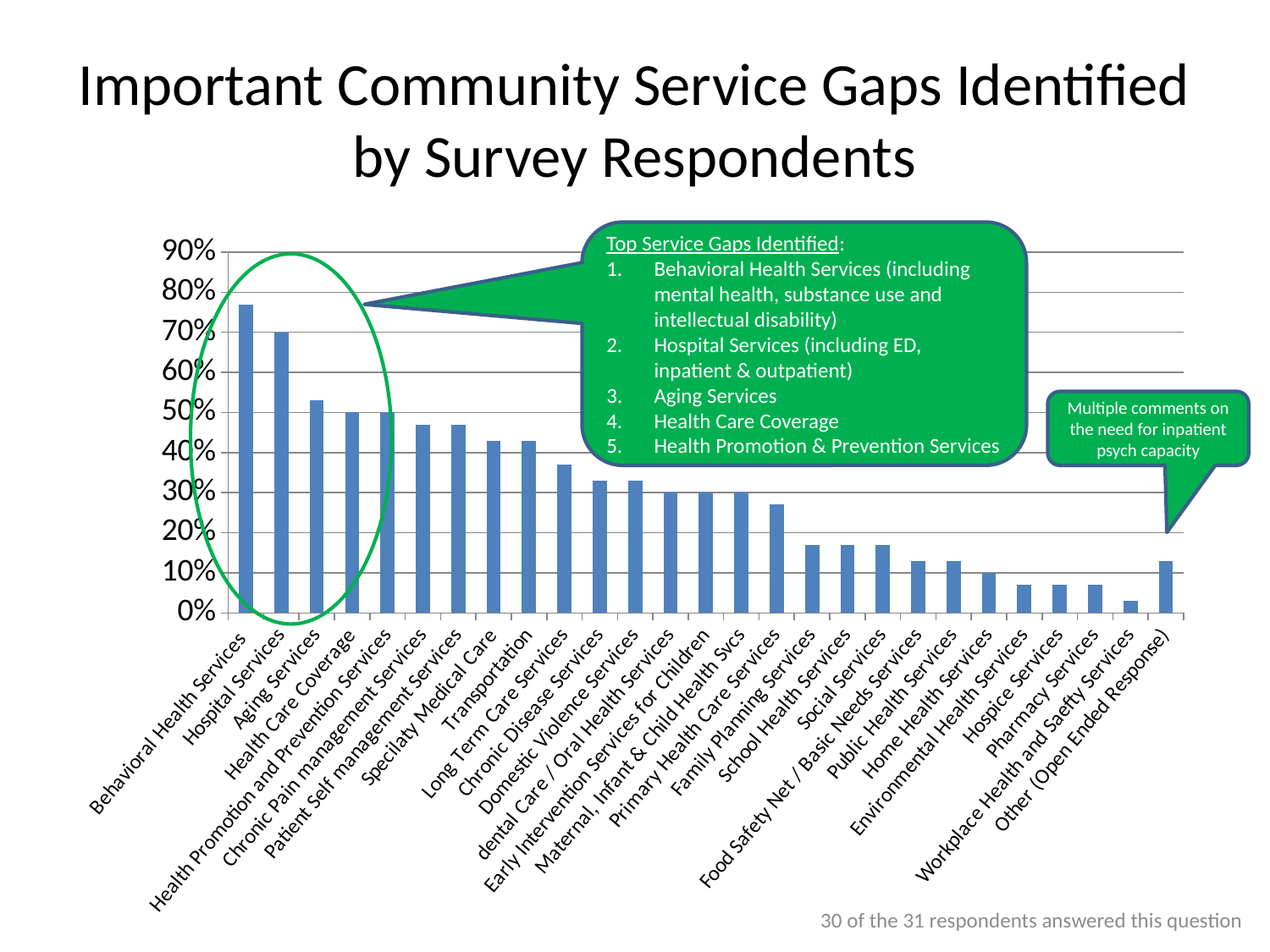
Is the value for Behavioral Health Services greater or less than 70%? greater Which category has the lowest value in the chart? Workplace Health and Saefty Services What type of chart is shown on the slide? Bar chart Which is larger, the value for Transportation or the value for Hospice Services? Transportation Is the value for Long Term Care Services greater or less than 40%? less Is the value for Aging Services greater or less than 50%? greater Which is larger, the value for Hospital Services or the value for Aging Services? Hospital Services What is the title of the slide containing the chart? Important Community Service Gaps Identified by Survey Respondents How many categories are plotted in the chart? 27 Which category has the highest value in the chart? Behavioral Health Services